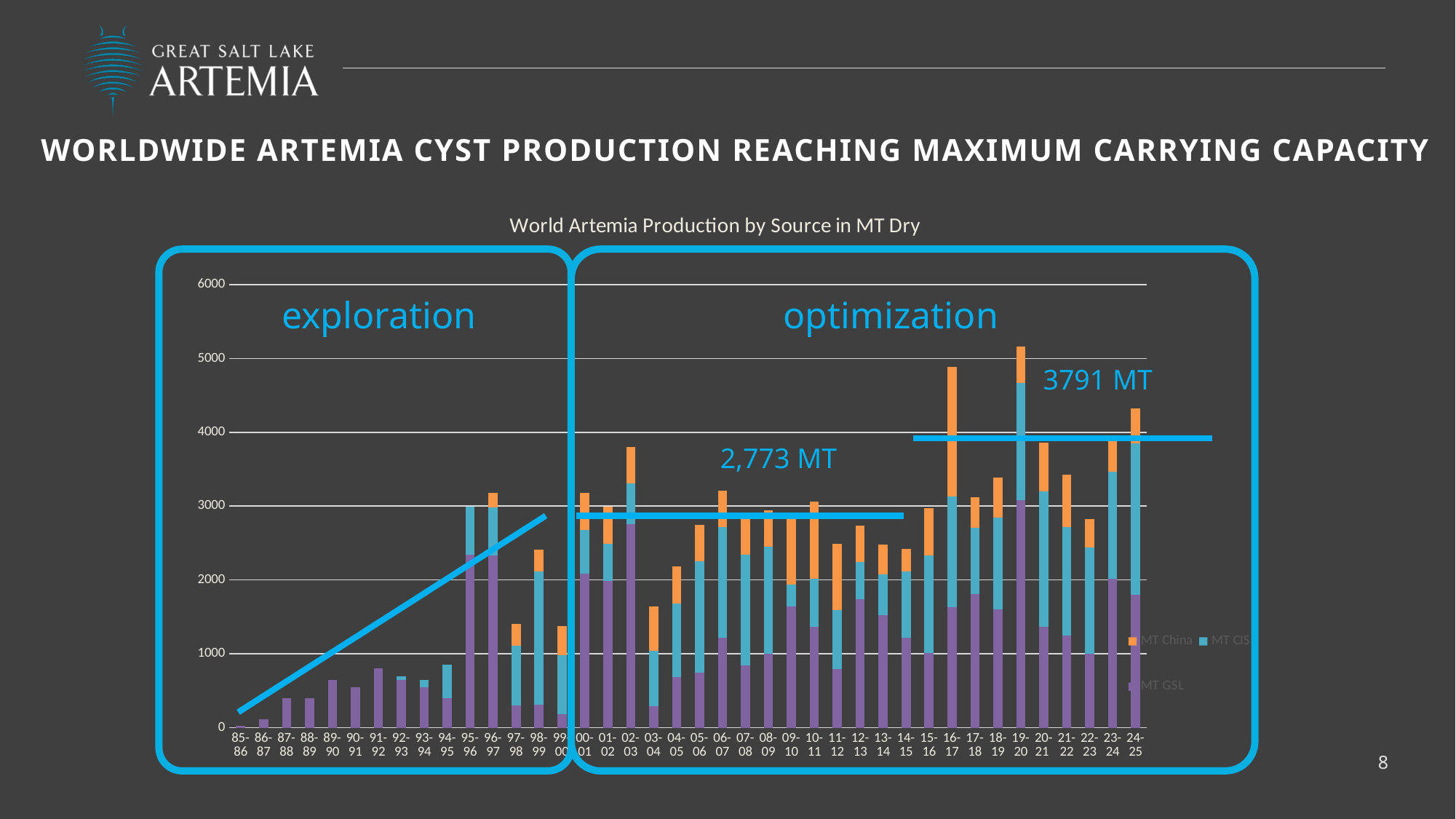
Which season has the shortest stacked bar in the chart? 85-86 What value is annotated above the horizontal line in the optimization phase on the right side of the chart? 3791 MT What is the title of the chart? World Artemia Production by Source in MT Dry Is the total production for 24-25 greater or less than 4000? greater Is the total production for 03-04 greater or less than 2000? less Is the total production for 16-17 greater or less than 4000? greater Which season has the tallest stacked bar in the chart? 19-20 How many season categories are shown along the x axis of the chart? 40 How many series does the chart's legend list? 3 Which season has the larger total production, 16-17 or 17-18? 16-17 Do the stacked bar totals generally rise or fall from 85-86 to 96-97? rise What kind of chart is shown on the slide? Stacked bar chart